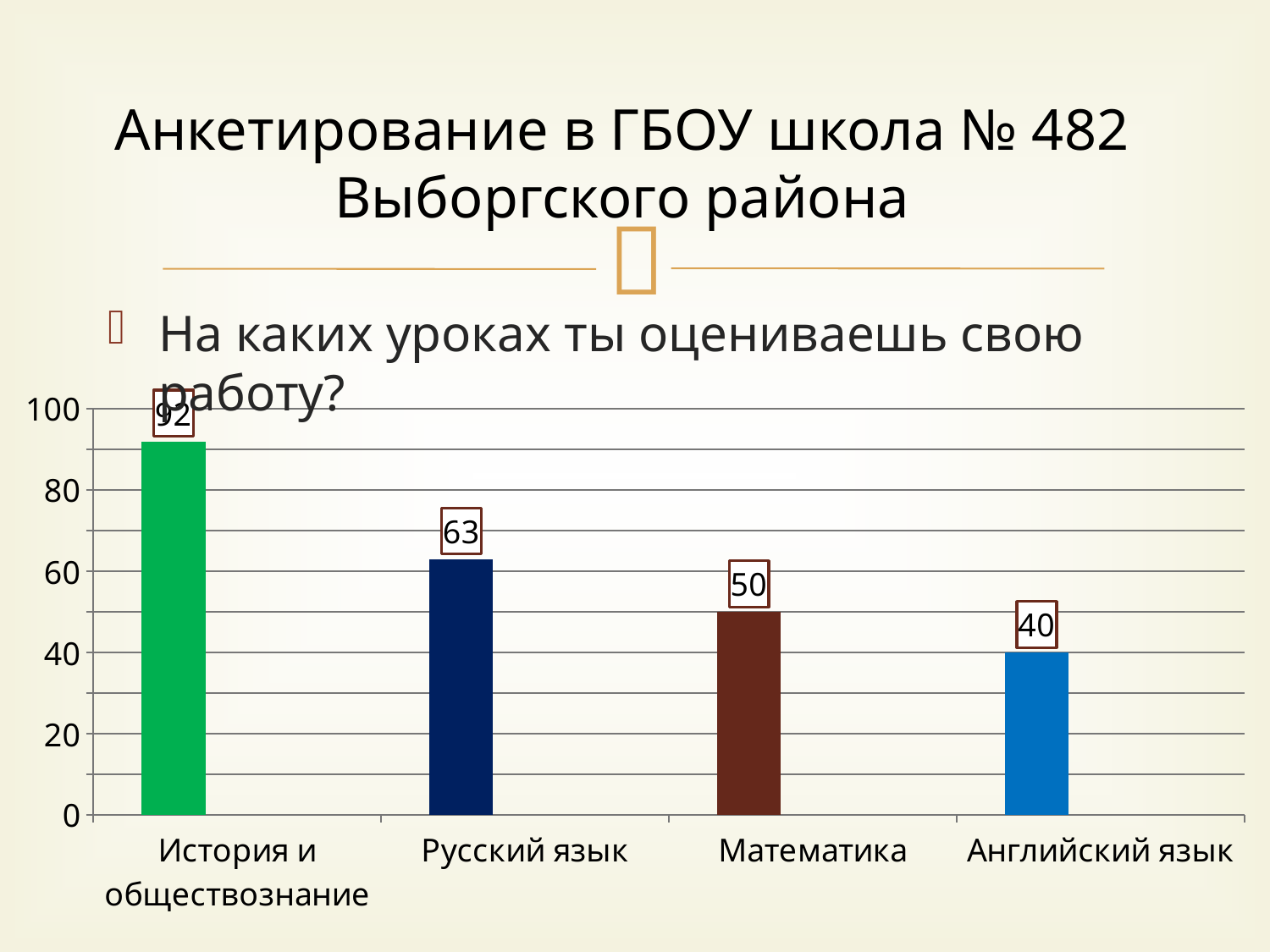
What is the value for Математика? 50 How many categories are shown in the chart? 4 What is the value for Английский язык? 40 What is the difference between the values for История и обществознание and Русский язык? 29 Which category has the highest value? История и обществознание What kind of chart is shown on the slide? bar chart Is the value for Русский язык greater or less than 60? greater Which category has the lowest value? Английский язык What is the value for Русский язык? 63 What is the value for История и обществознание? 92 What is the difference between the values for Математика and Английский язык? 10 Which is larger, the value for Русский язык or the value for Математика? Русский язык